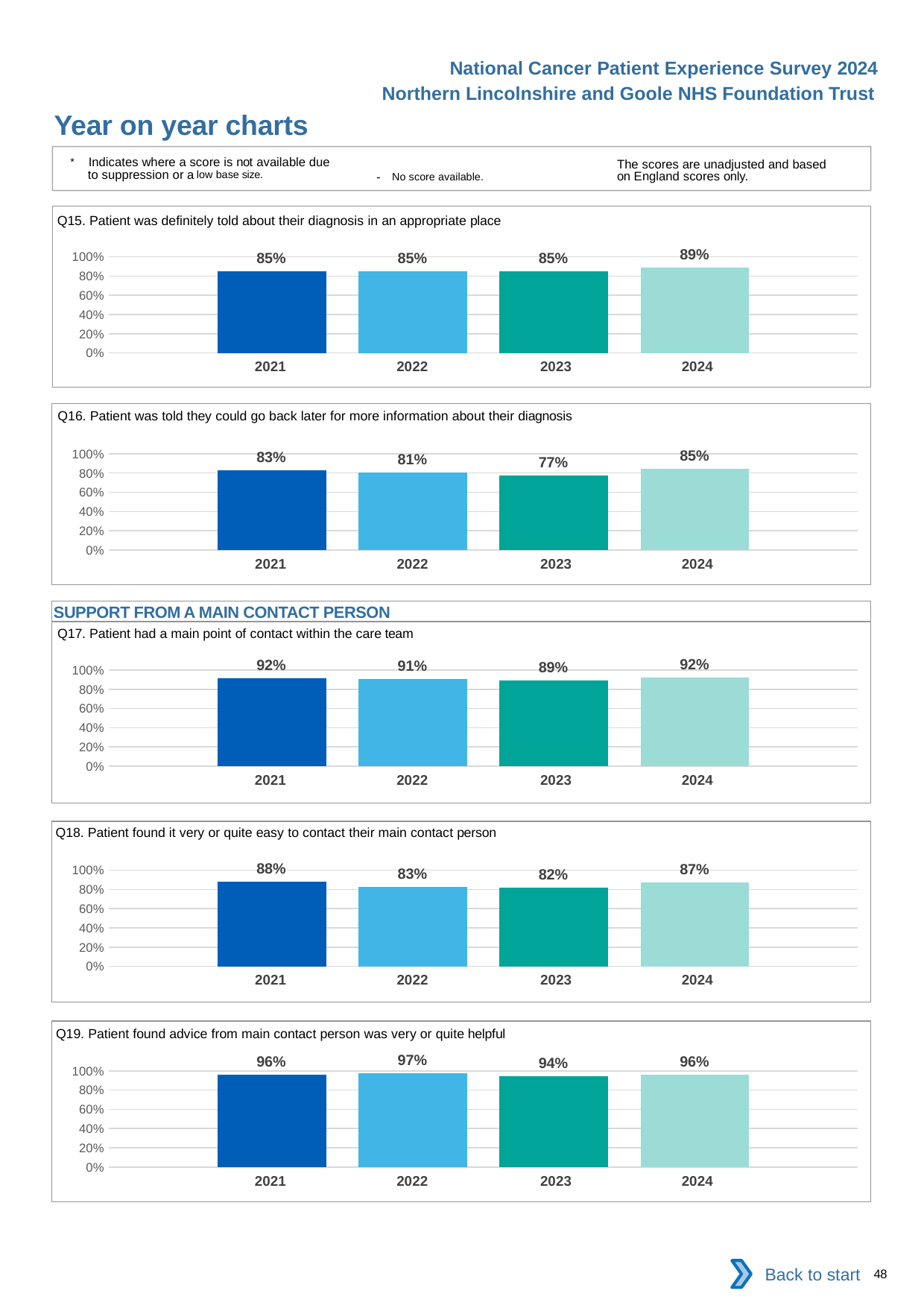
In the Q16 chart, do the values rise or fall from 2021 to 2023? fall In the Q18 chart, what is the difference between the 2021 value and the 2023 value? 6 percentage points In the Q19 chart, what is the value for 2022? 97% In the Q15 chart, what is the value for 2024? 89% In the Q18 chart, which year has the highest value? 2021 In the Q17 chart, what is the value for 2023? 89% How many years are shown on the x axis of the Q15 chart? 4 In the Q18 chart, is the value for 2022 larger or smaller than the value for 2024? smaller In the Q16 chart, what is the difference between the 2024 value and the 2023 value? 8 percentage points In the Q19 chart, which year has the lowest value? 2023 In the Q16 chart, which year has the lowest value? 2023 What type of chart is used for Q17? bar chart